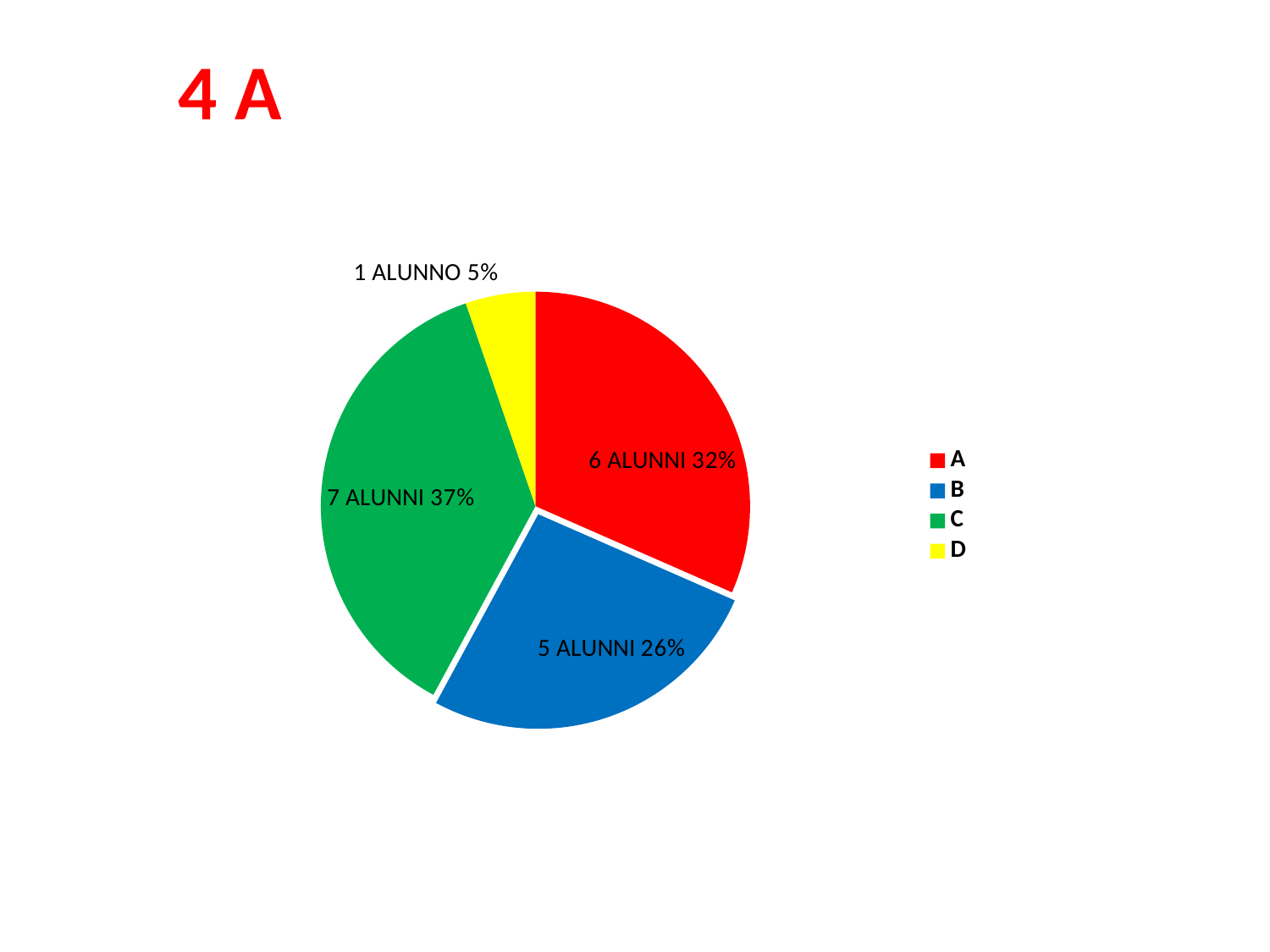
Which category has the smallest slice? D How many entries does the legend list? 4 What kind of chart is shown on the slide? pie chart How many alunni are in category C? 7 ALUNNI Which colour represents category D in the legend? yellow What share of the pie does category C represent? 37% What share of the pie does category D represent? 5% How many slices does the pie chart have? 4 What share of the pie does category A represent? 32% Which category has the largest slice? C What is the difference in percentage points between category C and category B? 11% How many alunni are in category B? 5 ALUNNI